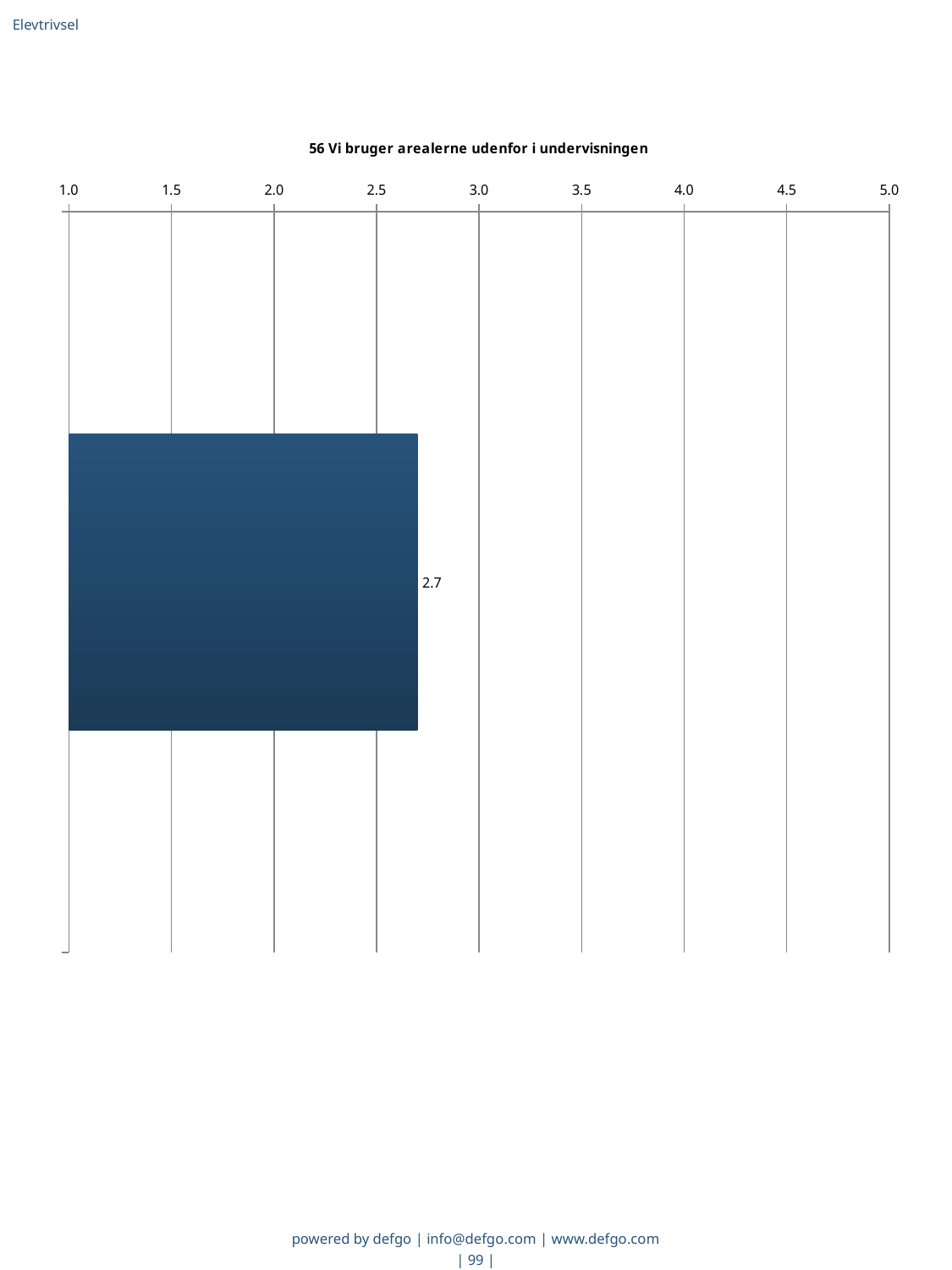
Is the value of the bar greater or less than 2.5? greater What kind of chart is shown on the slide? bar chart Is the value of the bar greater or less than 3.0? less How many bars are plotted in the chart? 1 What is the value shown by the bar in the chart? 2.7 What is the highest value shown on the chart's axis? 5.0 What is the title of the chart? 56 Vi bruger arealerne udenfor i undervisningen